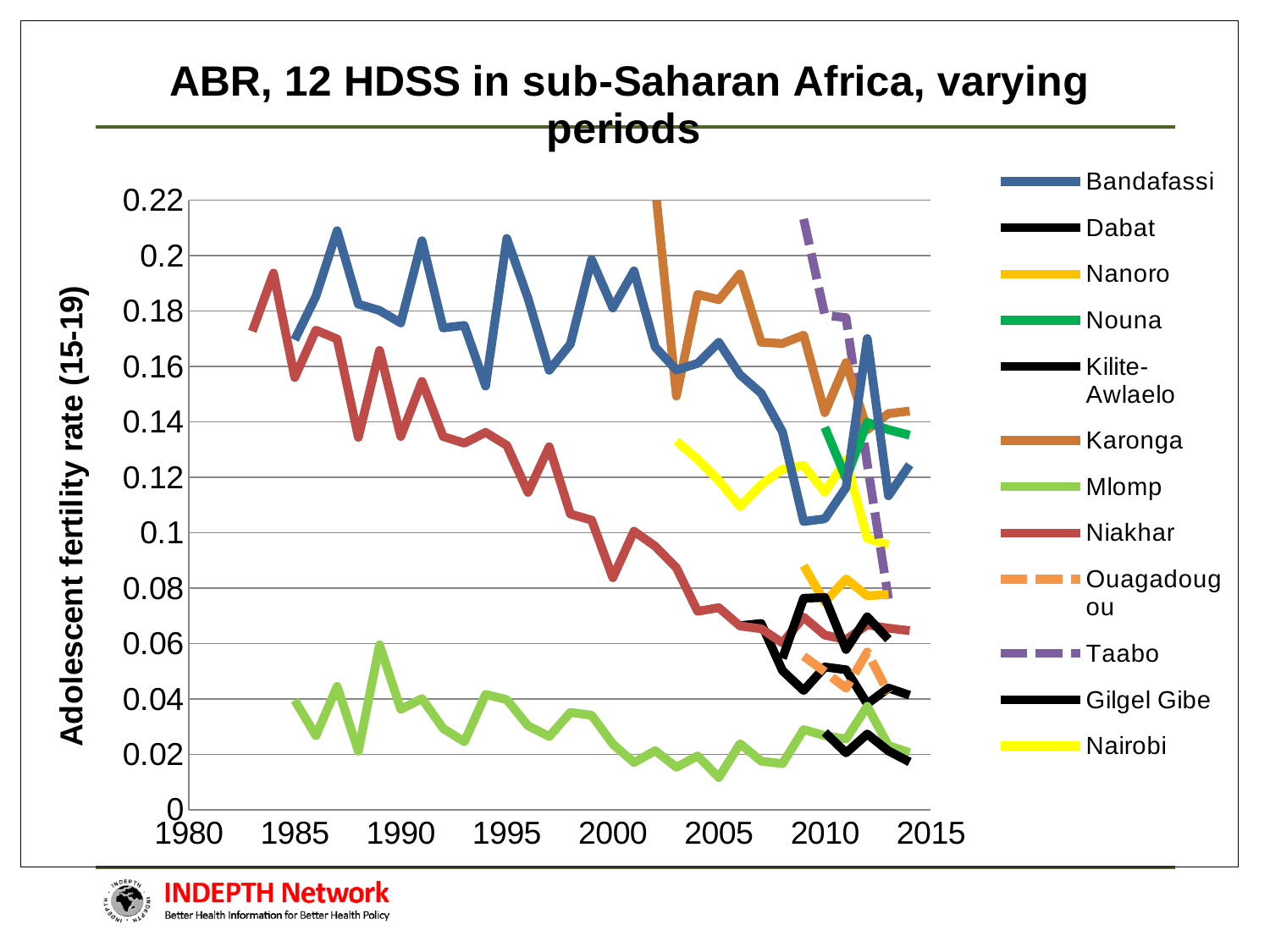
Is the value for Niakhar in 2014 greater or less than 0.1? less Does the Niakhar series rise or fall over time from 1983 to 2014? fall What kind of chart is shown on the slide? line chart What is the title of the chart? ABR, 12 HDSS in sub-Saharan Africa, varying periods In 2005, which is larger, the value for Karonga or the value for Nairobi? Karonga How many series does the legend list? 12 Is the highest value for Mlomp greater or less than 0.08? less In 2010, which is larger, the value for Bandafassi or the value for Niakhar? Bandafassi Does the Taabo series rise or fall over the years it covers? fall Is the value for Karonga in 2002 greater or less than 0.2? greater Which series has the lowest values across the whole chart? Mlomp What is the label on the vertical axis? Adolescent fertility rate (15-19)